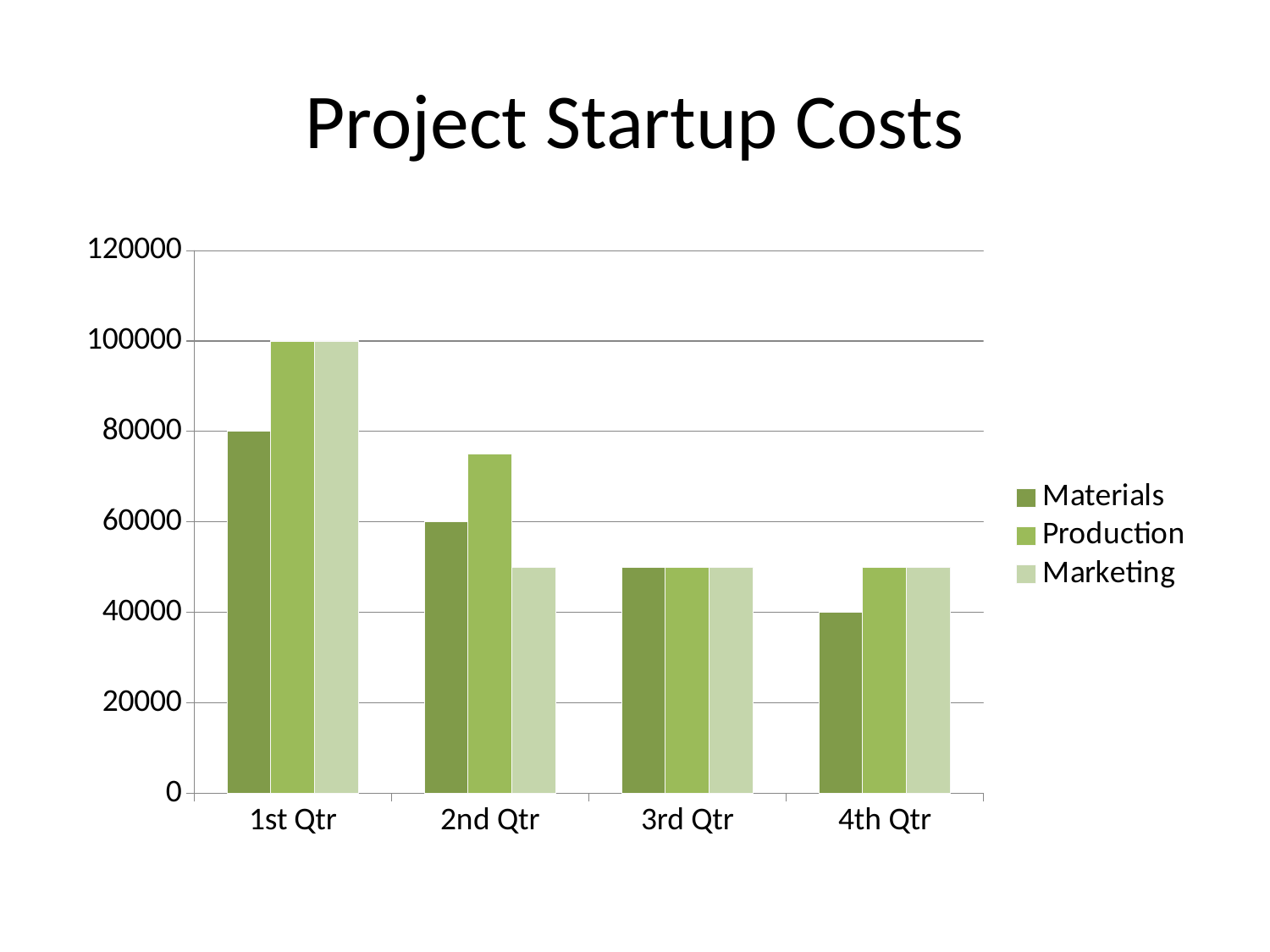
What is the Materials value for 1st Qtr? 80000 What is the Materials value for 4th Qtr? 40000 What is the Materials value for 2nd Qtr? 60000 Which quarter has the lowest Materials value? 4th Qtr How many quarters are shown on the x axis? 4 Is the Production value for 2nd Qtr greater or less than 60000? greater What is the Production value for 1st Qtr? 100000 Which is larger for 2nd Qtr, Production or Marketing? Production How many series does the legend list? 3 What type of chart is shown on the slide? bar chart Is the Marketing value for 3rd Qtr greater or less than 60000? less What is the title of the chart? Project Startup Costs